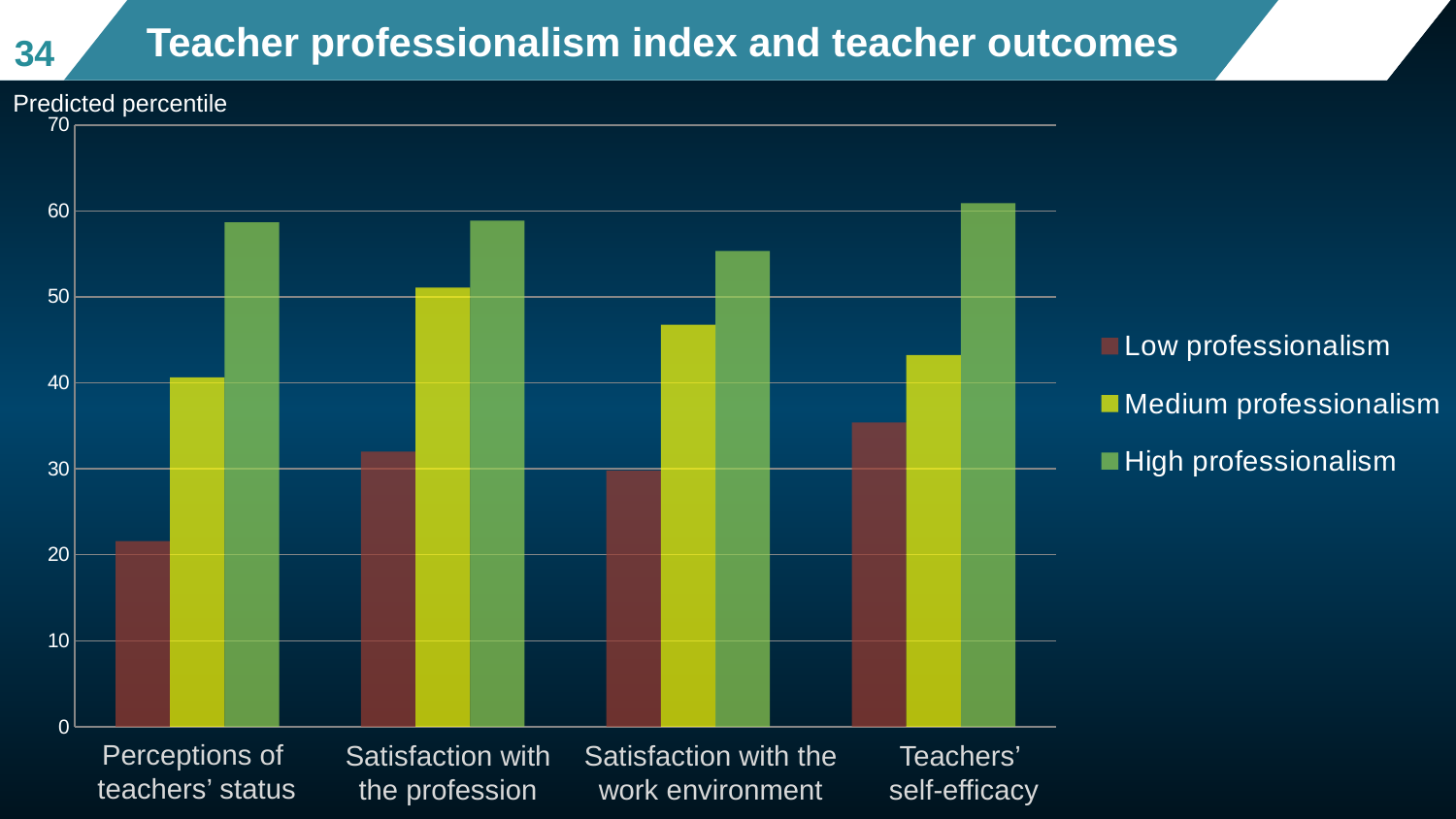
Is the Medium professionalism value for Satisfaction with the work environment greater or less than 50? less How many series does the legend list? 3 Which category has the lowest value for Low professionalism? Perceptions of teachers' status How many categories are shown on the x axis? 4 Which category has the highest value for Medium professionalism? Satisfaction with the profession What is the label on the vertical axis of the chart? Predicted percentile For Satisfaction with the work environment, which is larger: the Medium professionalism value or the High professionalism value? High professionalism Is the Low professionalism value for Perceptions of teachers' status greater or less than 30? less What kind of chart is shown on the slide? bar chart Is the High professionalism value for Perceptions of teachers' status greater or less than 50? greater Which category has the highest value for Low professionalism? Teachers' self-efficacy